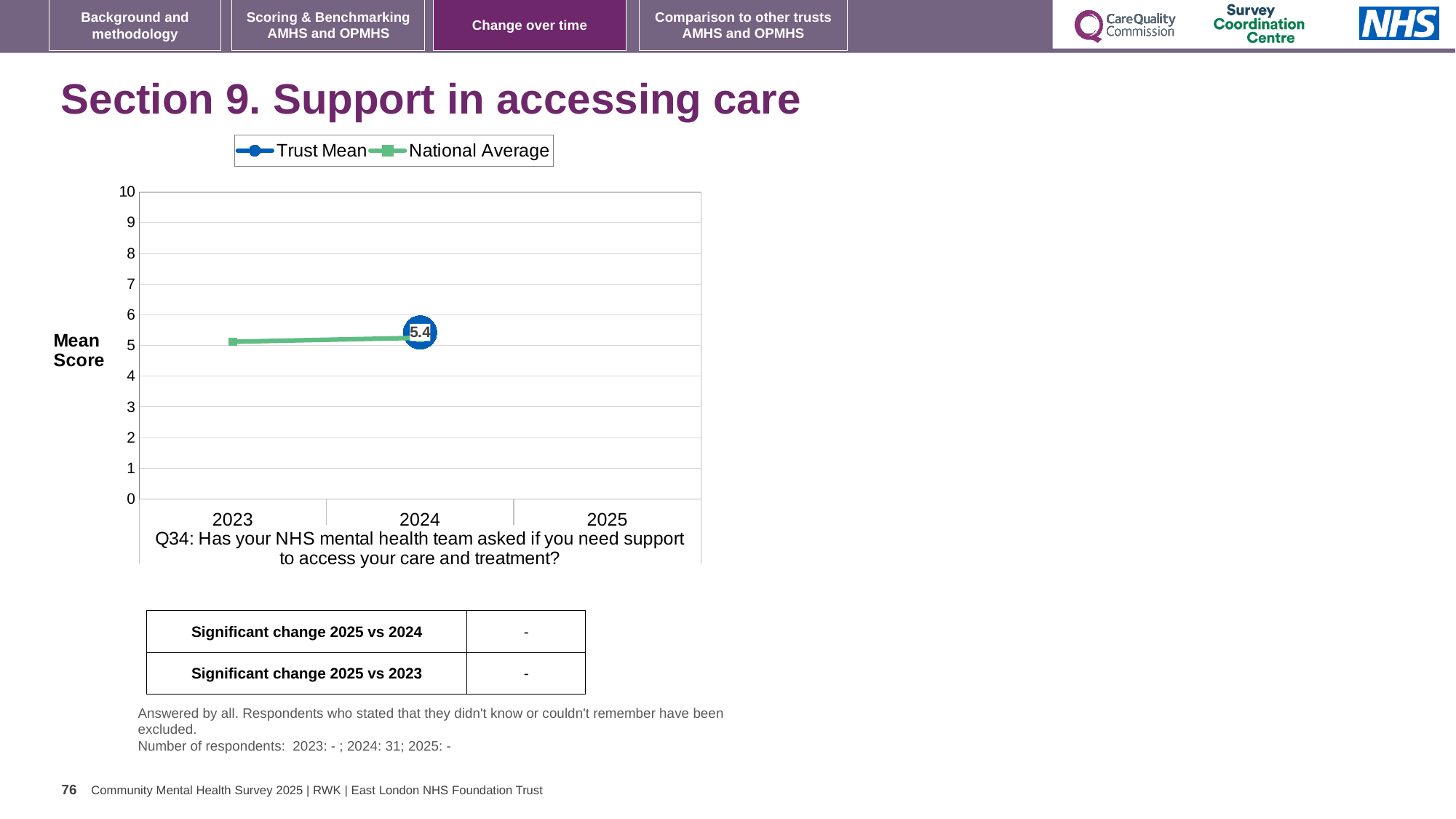
What is the highest value shown on the y axis? 10 What is the Trust Mean value for 2024? 5.4 What is the label on the y axis? Mean Score Is the National Average value for 2023 greater or less than 6? less What kind of chart is shown on the slide? line chart What are the two series named in the legend? Trust Mean and National Average Which year has a plotted Trust Mean data point? 2024 How many series does the legend list? 2 How many years are shown on the x axis? 3 Is the National Average value for 2024 greater or less than 4? greater Does the National Average rise or fall from 2023 to 2024? rise Is the Trust Mean value for 2024 greater or less than 5? greater